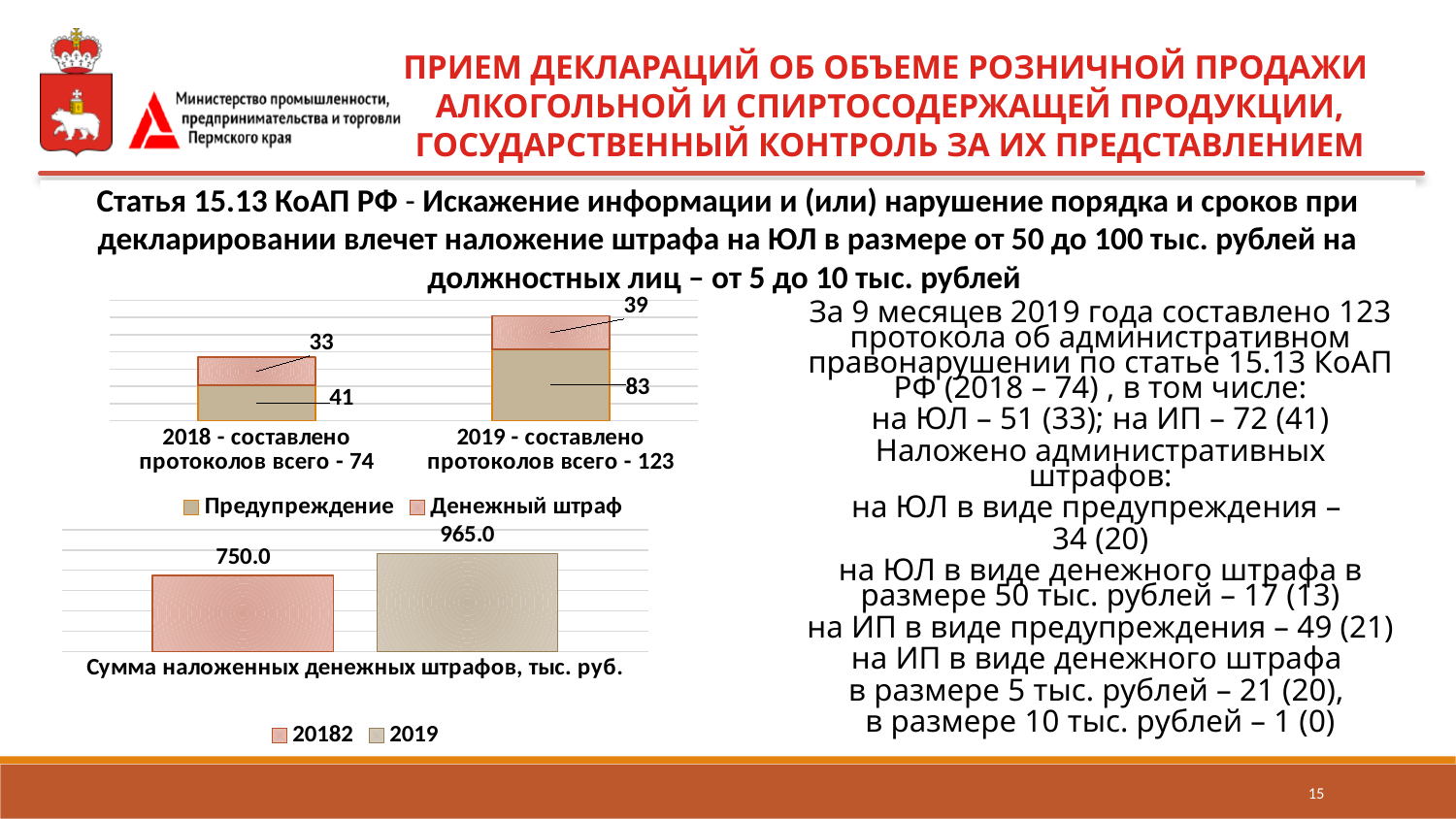
In the top chart, what is the total of the stacked bar for 2019? 122 In the top chart, which is larger in 2019: Предупреждение or Денежный штраф? Предупреждение In the top chart, what is the value for Денежный штраф in 2019? 39 In the chart 'Сумма наложенных денежных штрафов, тыс. руб.', what is the difference between the 2019 and 2018 values? 215.0 What kind of chart is the top chart? Stacked bar chart In the top chart, what is the difference between Предупреждение in 2019 and Предупреждение in 2018? 42 In the top chart, what is the value for Денежный штраф in 2018? 33 In the chart 'Сумма наложенных денежных штрафов, тыс. руб.', what is the value for the first (2018) bar? 750.0 How many series does the legend of the top chart list? 2 In the top chart, what is the value for Предупреждение in 2018? 41 In the chart 'Сумма наложенных денежных штрафов, тыс. руб.', what is the value for 2019? 965.0 In the chart 'Сумма наложенных денежных штрафов, тыс. руб.', which bar is higher, 2018 or 2019? 2019